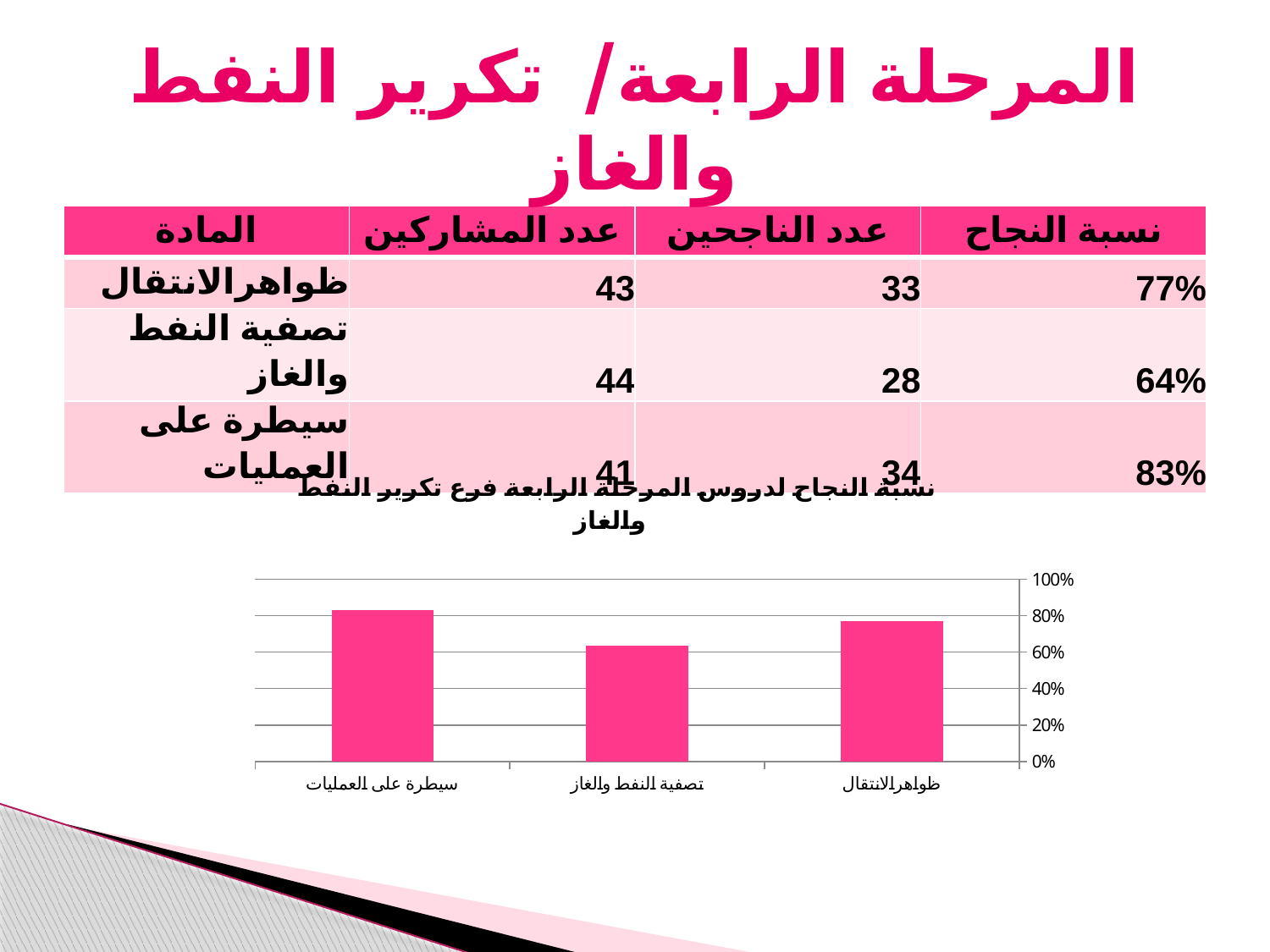
Which category has the lowest bar in the chart? تصفية النفط والغاز Which category has the highest bar in the chart? سيطرة على العمليات What is the difference between the success rates of سيطرة على العمليات and تصفية النفط والغاز shown on the slide? 19% According to the slide, what success rate is plotted for تصفية النفط والغاز? 64% Which is larger in the chart, the bar for ظواهر الانتقال or the bar for تصفية النفط والغاز? ظواهر الانتقال Is the value for سيطرة على العمليات greater or less than 80%? greater What kind of chart is shown on the slide? bar chart What is the maximum value shown on the chart's vertical axis? 100% How many categories are plotted on the x axis of the chart? 3 Is the value for تصفية النفط والغاز greater or less than 80%? less According to the slide, what success rate is plotted for سيطرة على العمليات? 83% Is the value for ظواهر الانتقال greater or less than 60%? greater